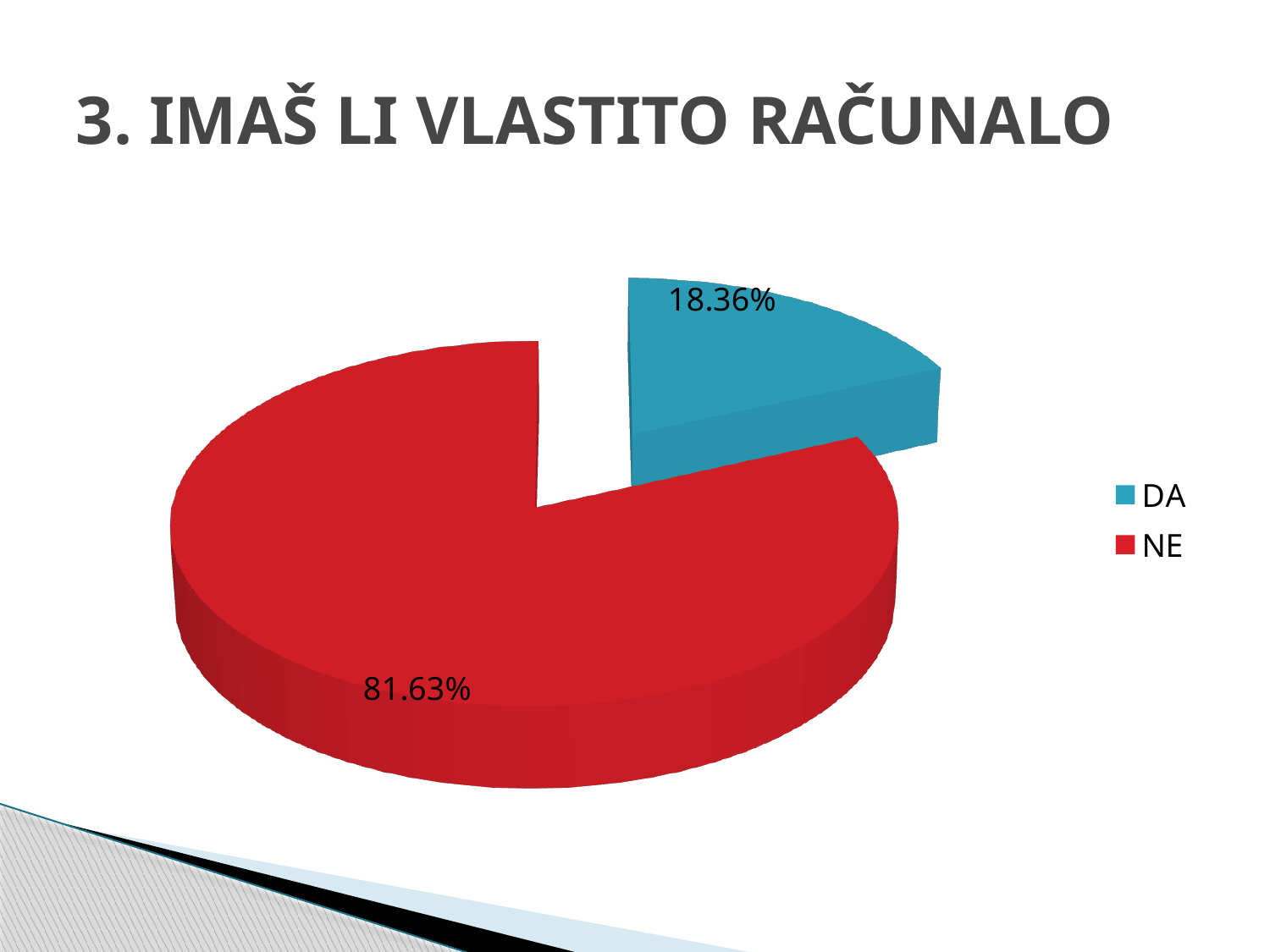
How many slices does the pie chart have? 2 Which category has the smallest share of the pie chart? DA What is the difference in percentage points between the NE slice and the DA slice? 63.27 What kind of chart is shown on the slide? pie chart What colour is the NE slice in the pie chart? red What percentage of the pie chart is labelled for the DA slice? 18.36% What percentage of the pie chart is labelled for the NE slice? 81.63% Which slice is larger, DA or NE? NE What is the title of the slide? 3. IMAŠ LI VLASTITO RAČUNALO Which category has the largest share of the pie chart? NE How many entries does the legend list? 2